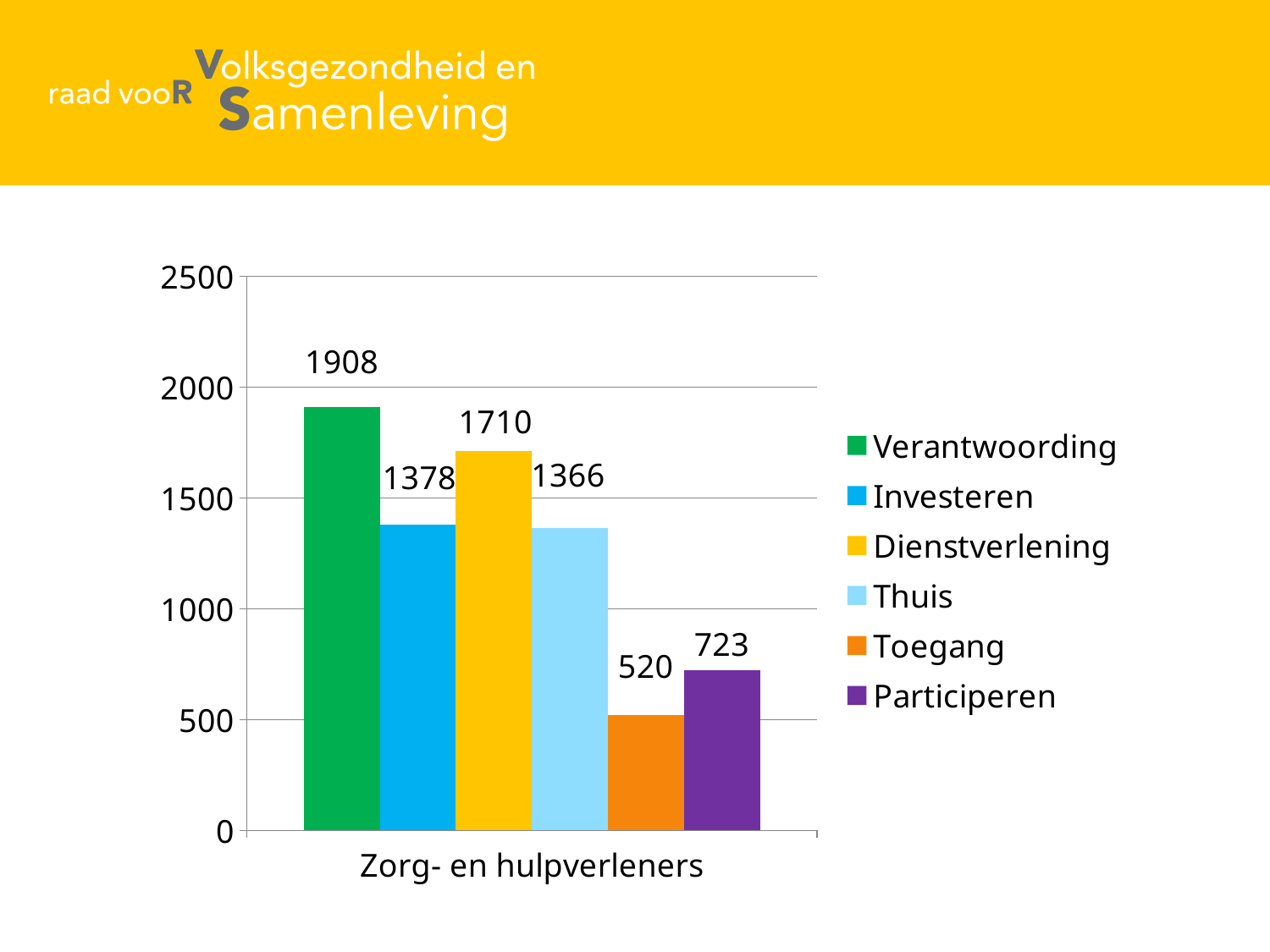
Which series has the highest value? Verantwoording What is the value for Verantwoording? 1908 What is the value for Dienstverlening? 1710 What is the value for Investeren? 1378 What is the difference between the values for Verantwoording and Dienstverlening? 198 What is the difference between the values for Participeren and Toegang? 203 What is the value for Toegang? 520 Which series has the lowest value? Toegang Which is larger, the value for Dienstverlening or the value for Thuis? Dienstverlening What is the label on the x axis of the chart? Zorg- en hulpverleners How many series does the legend list? 6 What kind of chart is shown on the slide? Bar chart